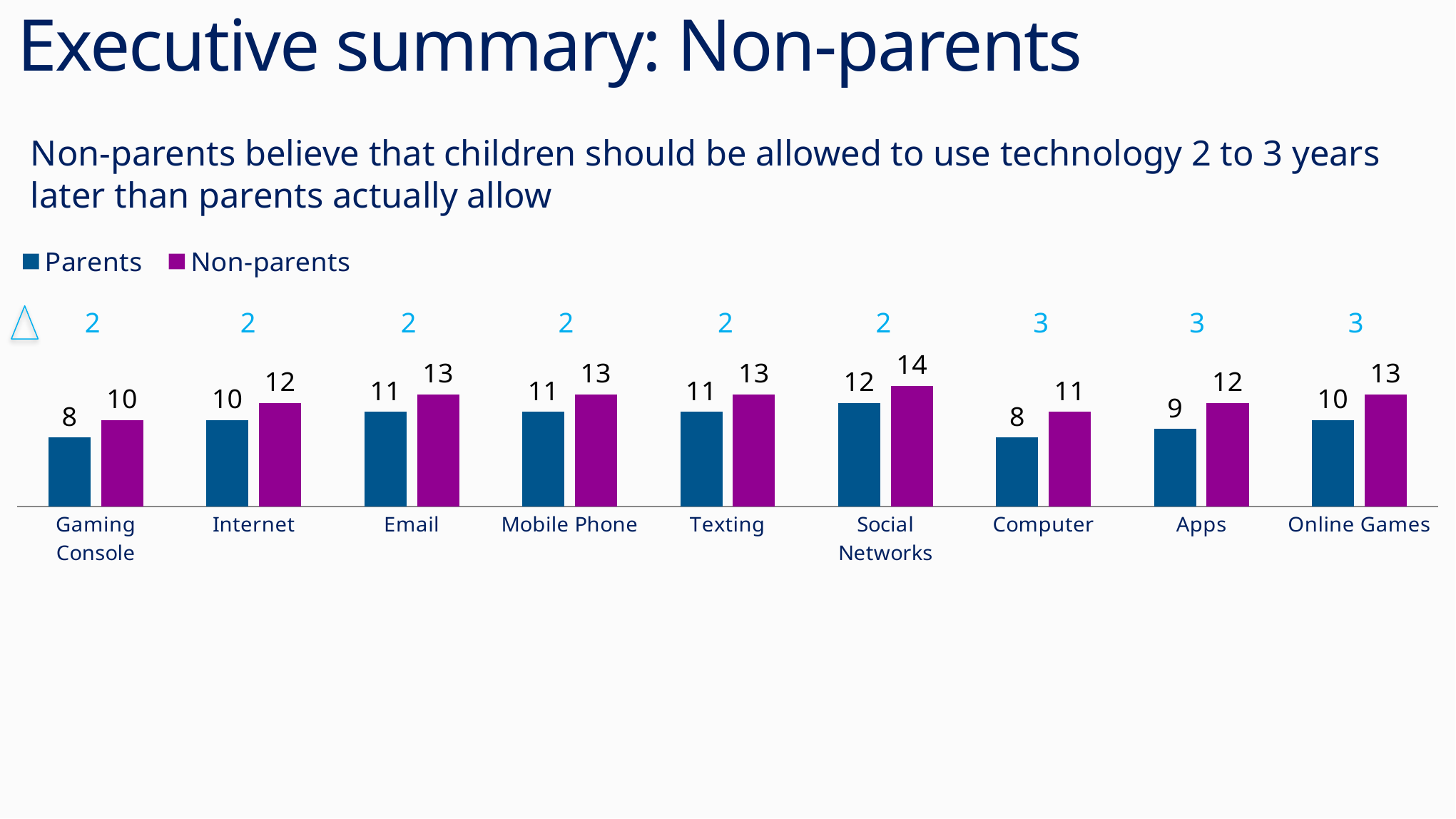
What is the Parents value for Gaming Console? 8 How many series does the legend list? 2 Which category has the lowest Non-parents value? Gaming Console What is the Non-parents value for Computer? 11 What is the Non-parents value for Social Networks? 14 What is the difference between the Non-parents and Parents values for Online Games? 3 Which category has the highest Non-parents value? Social Networks How many categories are shown on the x axis? 9 What are the two series named in the legend? Parents and Non-parents Which is larger for Apps: the Parents value or the Non-parents value? Non-parents What is the Parents value for Social Networks? 12 What kind of chart is shown on the slide? Bar chart